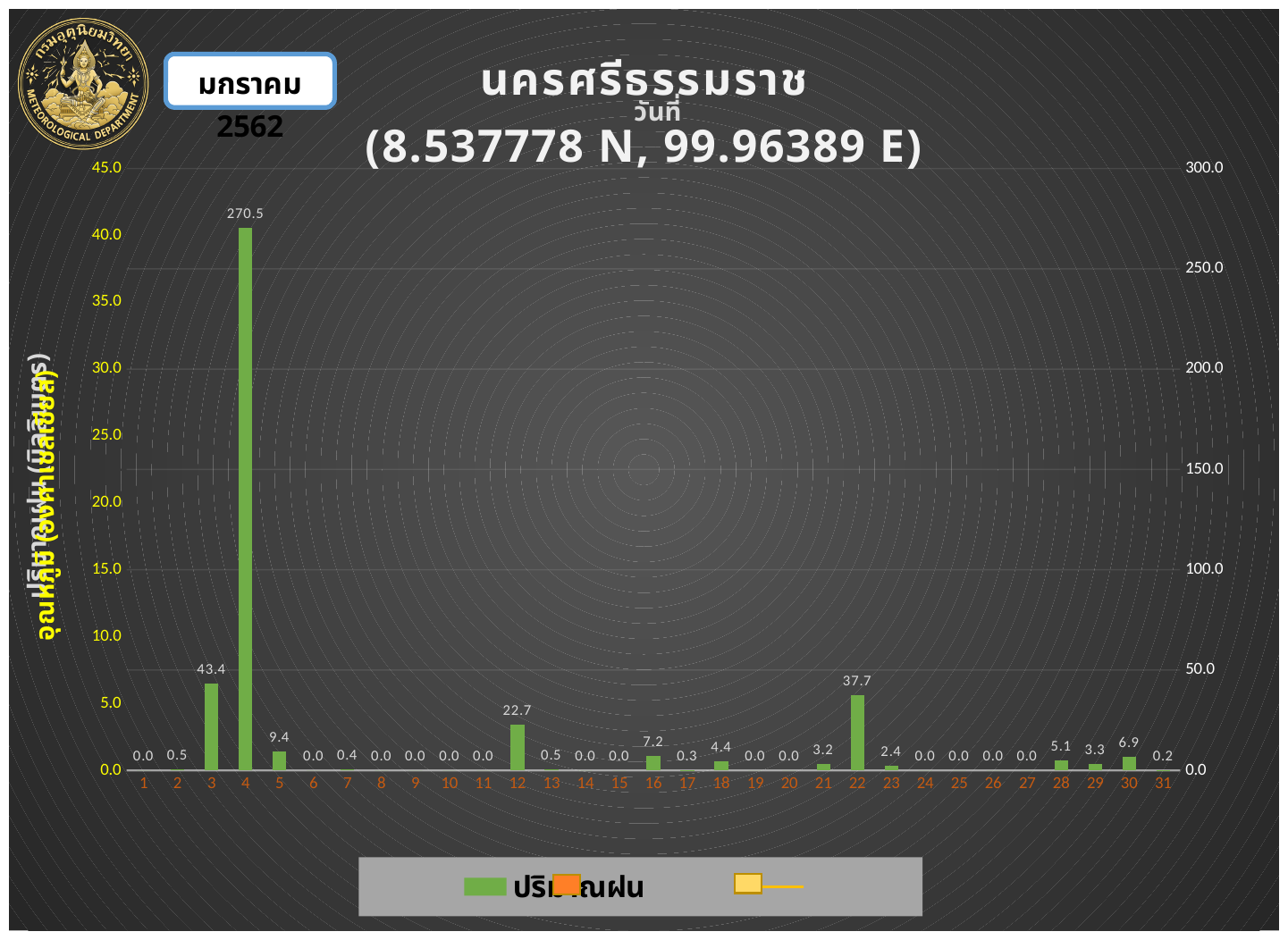
What is the difference between the rainfall values for day 22 and day 12? 15.0 What is the highest value shown on the right-hand vertical axis? 300.0 Which day has the highest rainfall value? 4 How many days (categories) are shown on the x axis? 31 What is the difference between the rainfall values for day 4 and day 3? 227.1 Which is larger, the rainfall value for day 3 or for day 22? day 3 What is the rainfall value shown for day 30? 6.9 What is the rainfall value shown for day 12? 22.7 What is the rainfall value shown for day 4? 270.5 What is the rainfall value shown for day 22? 37.7 What kind of chart is shown on the slide? bar chart Which is larger, the rainfall value for day 16 or for day 18? day 16